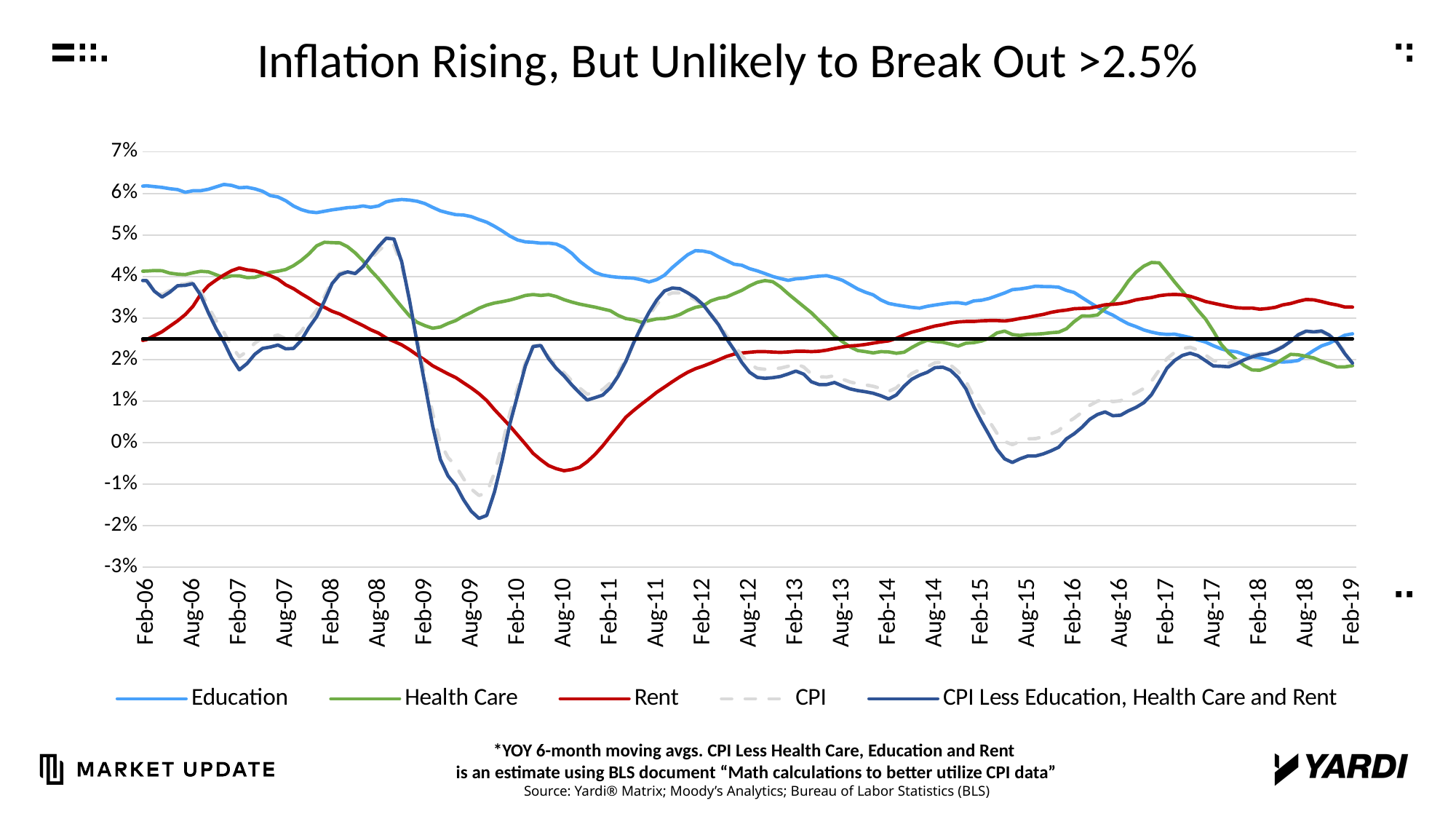
Which series has the lowest value at Aug-09? CPI Less Education, Health Care and Rent Does the Education series rise or fall overall from Feb-06 to Feb-19? fall Is the value for Education at Feb-06 greater or less than 5%? greater At Aug-15, which is higher, Rent or CPI? Rent Is the value for Health Care at Feb-17 greater or less than 4%? greater Is the value for Rent at Aug-10 greater or less than 0%? less At what level is the horizontal black reference line drawn across the chart? 2.5% How many series does the legend list? 5 What kind of chart is shown on the slide? line chart What is the title of the chart? Inflation Rising, But Unlikely to Break Out >2.5% Which series has the highest value at Feb-06? Education